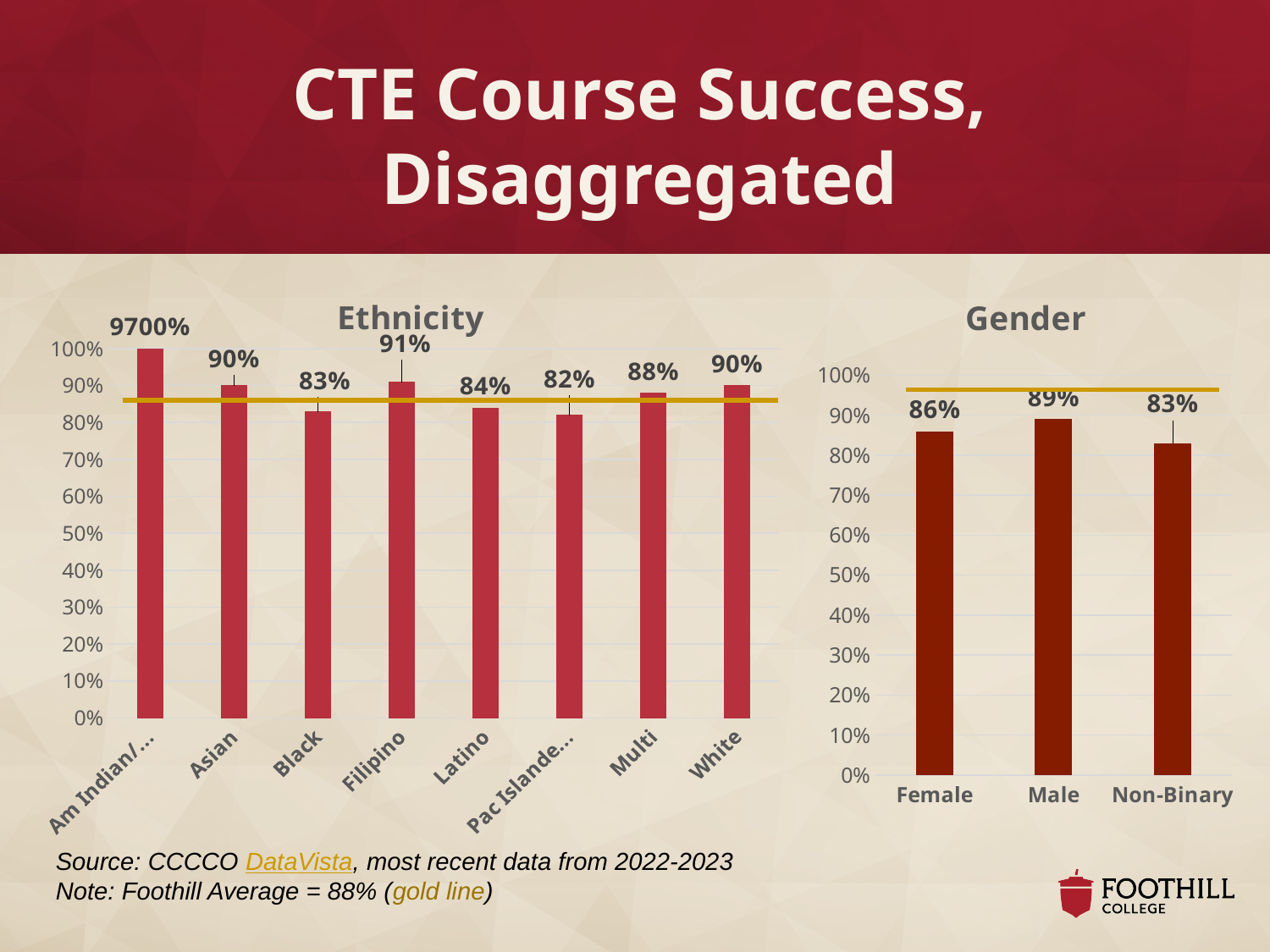
What kind of chart is the Gender chart? Bar chart In the Ethnicity chart, what is the CTE course success rate for Asian students? 90% In the Ethnicity chart, which is larger, the value for Filipino or the value for Latino? Filipino In the Gender chart, which category has the highest value? Male In the Gender chart, what is the value for Female? 86% In the Ethnicity chart, what is the value for Filipino students? 91% In the Gender chart, what is the difference between the Male value and the Non-Binary value? 6 percentage points In the Ethnicity chart, what is the value for Latino students? 84% In the Ethnicity chart, how many ethnicity categories are plotted? 8 In the Ethnicity chart, what is the value for Multi? 88% In the Ethnicity chart, what is the value for Black students? 83% In the Gender chart, which category has the lowest value? Non-Binary